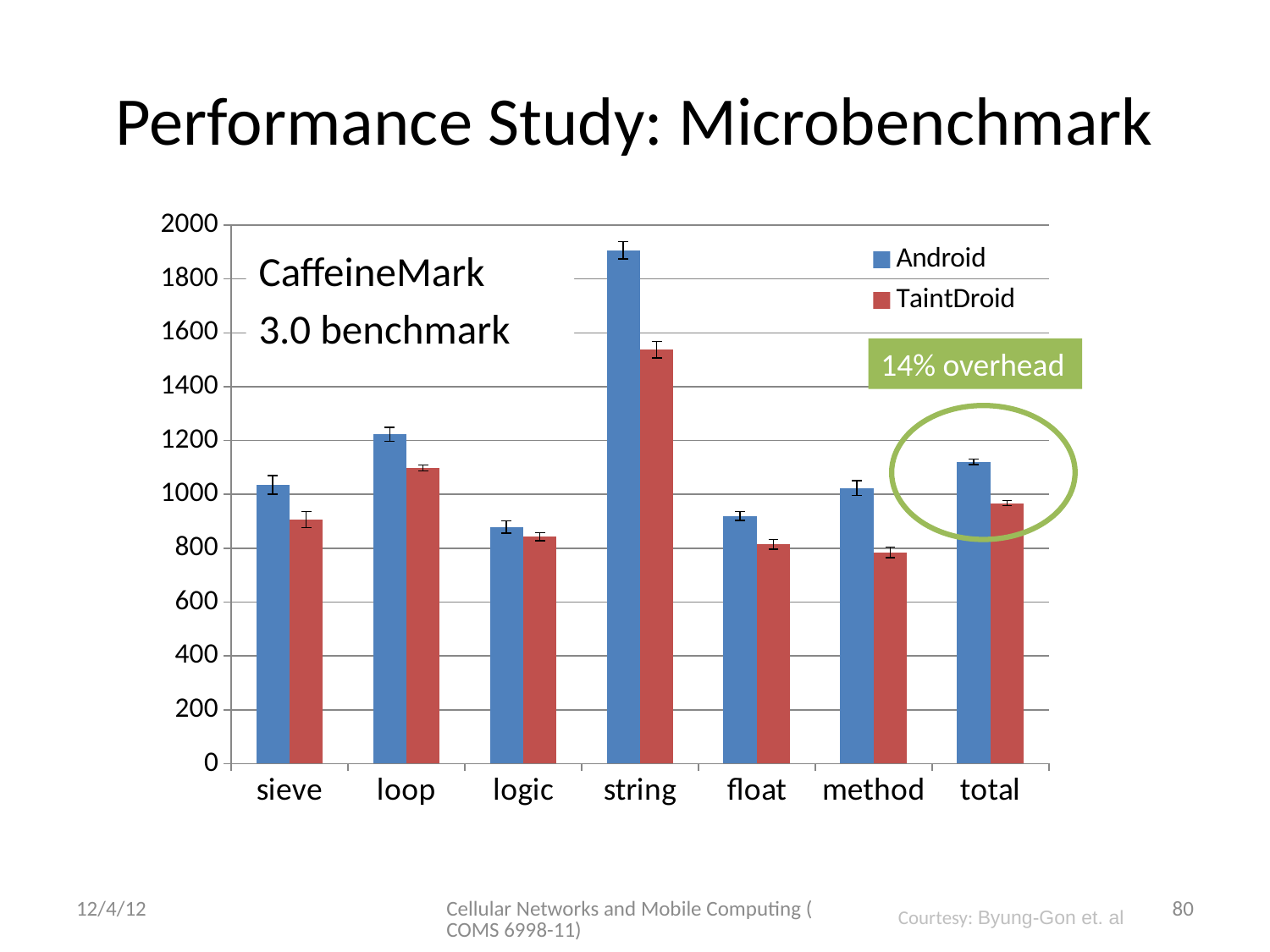
How many benchmark categories are shown on the x axis? 7 For which category is the Android value highest? string For which category is the TaintDroid value highest? string Is the TaintDroid value for method greater or less than 1000? less What overhead percentage is called out in the green box on the chart? 14% overhead For the sieve category, which is larger: the Android value or the TaintDroid value? Android Is the Android value for total greater or less than 1000? greater What kind of chart is shown on the slide? bar chart For which category is the Android value lowest? logic Is the Android value for string greater or less than 1800? greater How many series does the legend list? 2